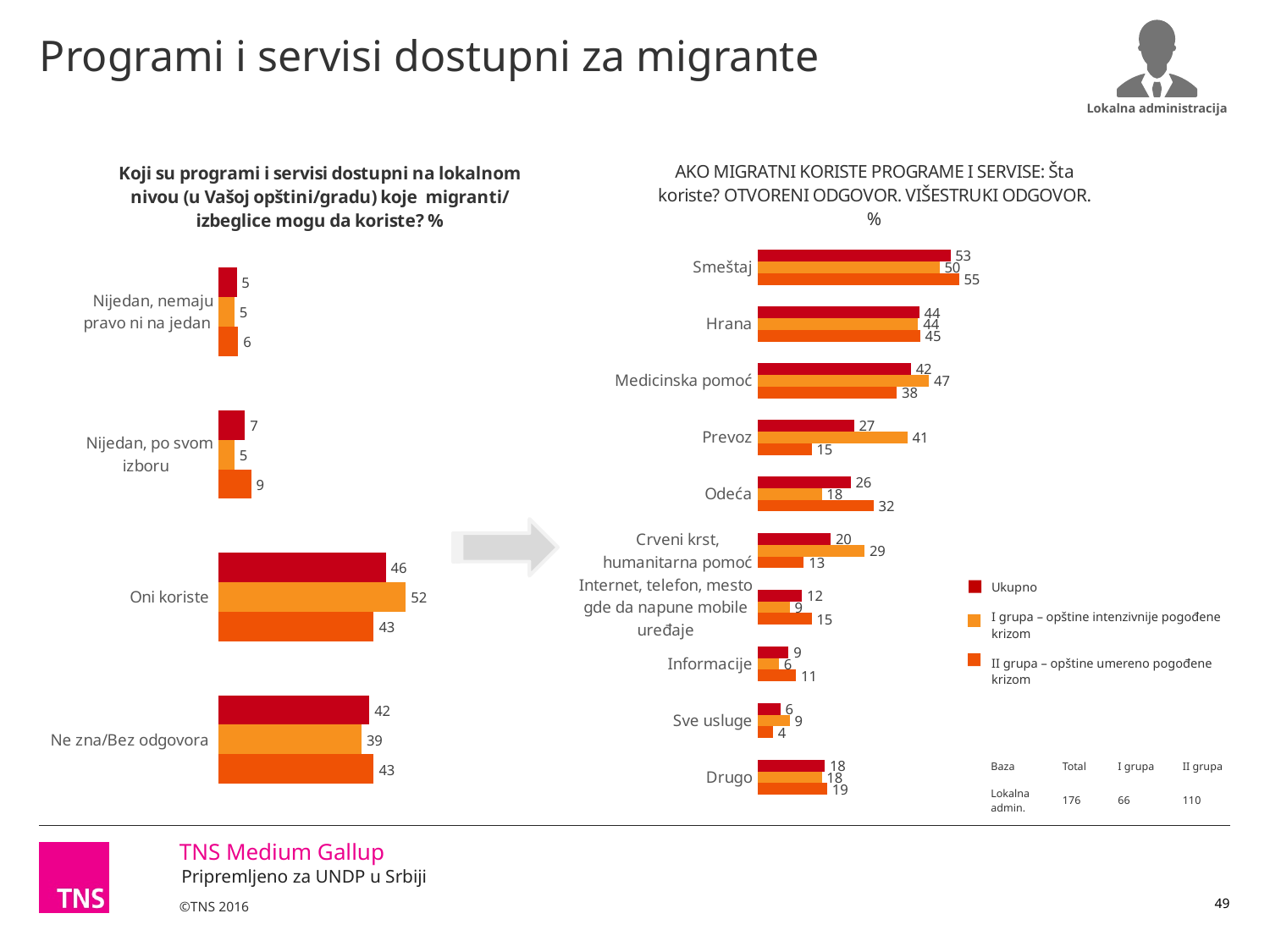
In the right chart (AKO MIGRATNI KORISTE PROGRAME I SERVISE), which is larger for 'Odeća': the I grupa value or the II grupa value? II grupa What type of chart is the right chart (AKO MIGRATNI KORISTE PROGRAME I SERVISE)? Bar chart In the left chart (Koji su programi i servisi dostupni na lokalnom nivou), what is the Ukupno value for 'Oni koriste'? 46 In the left chart (Koji su programi i servisi dostupni na lokalnom nivou), how many categories are shown? 4 In the right chart (AKO MIGRATNI KORISTE PROGRAME I SERVISE), what is the II grupa value for 'Medicinska pomoć'? 38 In the right chart (AKO MIGRATNI KORISTE PROGRAME I SERVISE), what is the I grupa value for 'Prevoz'? 41 In the right chart (AKO MIGRATNI KORISTE PROGRAME I SERVISE), which category has the lowest II grupa value? Sve usluge In the right chart (AKO MIGRATNI KORISTE PROGRAME I SERVISE), which category has the highest Ukupno value? Smeštaj In the left chart (Koji su programi i servisi dostupni na lokalnom nivou), what is the difference between the I grupa and II grupa values for 'Oni koriste'? 9 In the left chart (Koji su programi i servisi dostupni na lokalnom nivou), what is the I grupa value for 'Ne zna/Bez odgovora'? 39 In the right chart (AKO MIGRATNI KORISTE PROGRAME I SERVISE), what is the difference between the I grupa and II grupa values for 'Prevoz'? 26 How many series does the legend list? 3